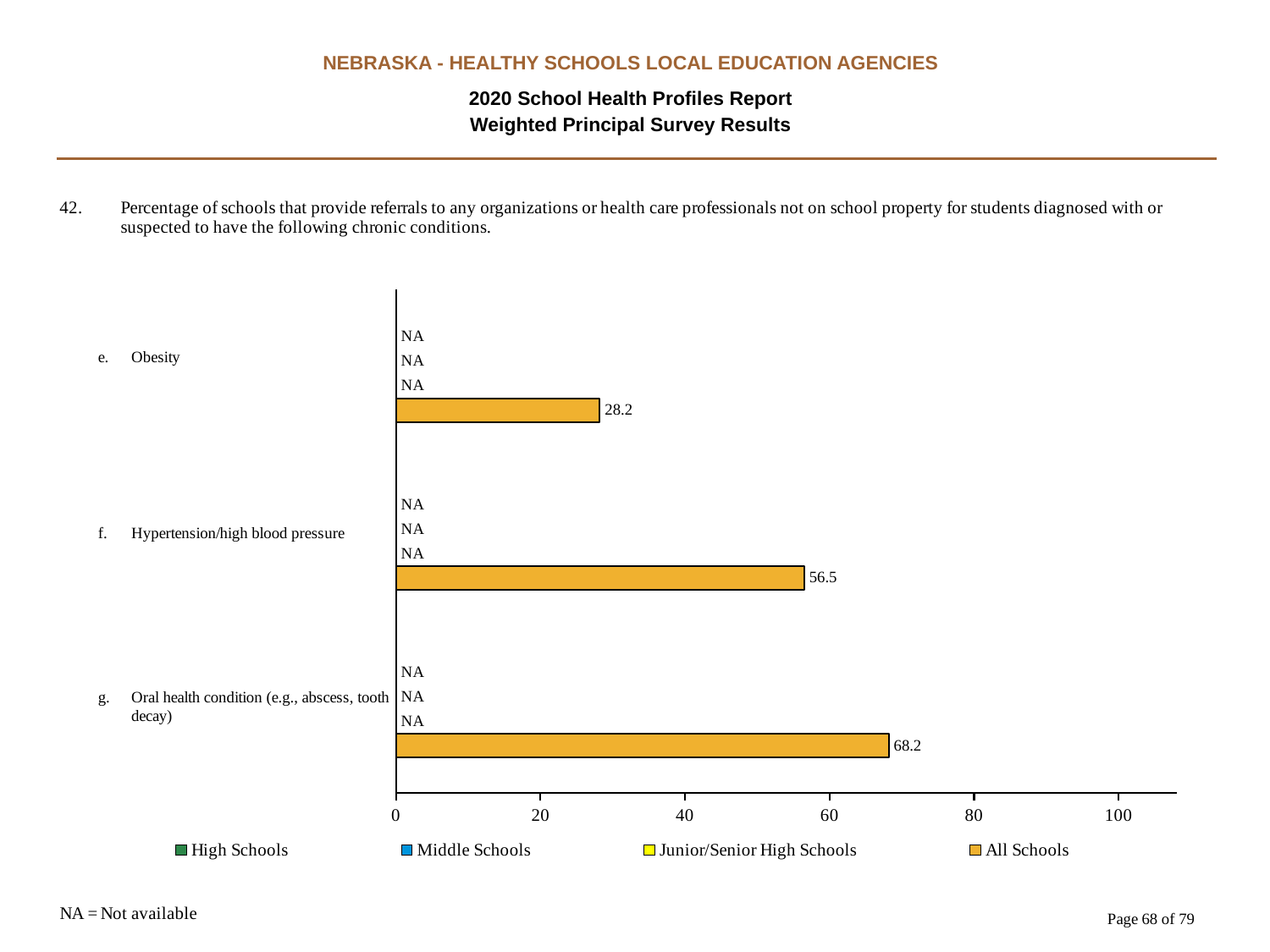
What is the All Schools value for Oral health condition (e.g., abscess, tooth decay)? 68.2 What kind of chart is shown on the slide? bar chart Which condition has the highest All Schools value? Oral health condition (e.g., abscess, tooth decay) Which is larger, the All Schools value for Hypertension/high blood pressure or for Obesity? Hypertension/high blood pressure What is the difference between the All Schools values for Oral health condition and Obesity? 40.0 What is the All Schools value for Obesity? 28.2 How many chronic conditions are listed on the chart? 3 How many series does the legend list? 4 What is the All Schools value for Hypertension/high blood pressure? 56.5 What is the difference between the All Schools values for Hypertension/high blood pressure and Obesity? 28.3 Which condition has the lowest All Schools value? Obesity Is the All Schools value for Hypertension/high blood pressure greater or less than 60? less